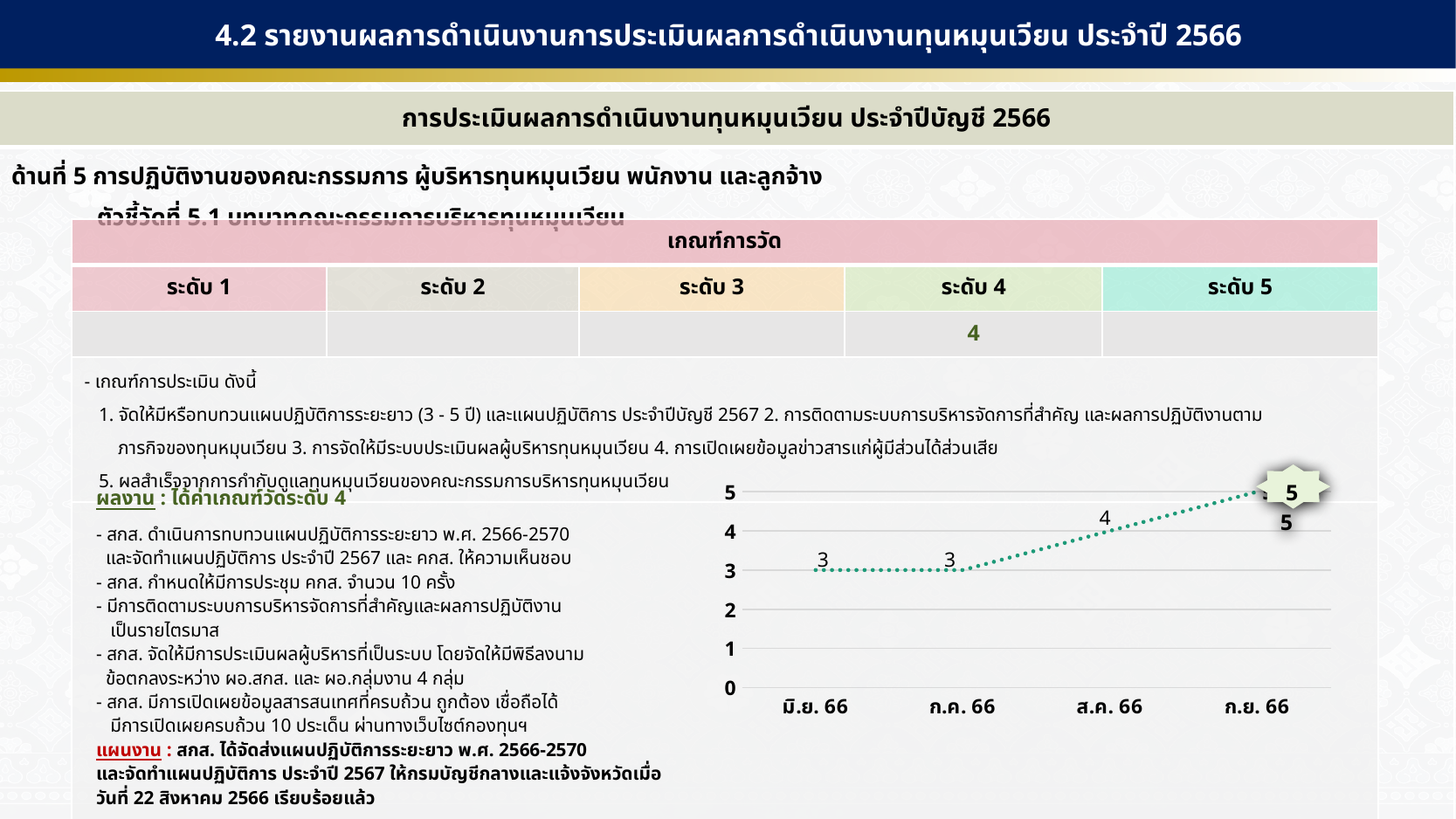
Which month has the highest value? ก.ย. 66 Which is larger, the value for ส.ค. 66 or the value for ก.ค. 66? ส.ค. 66 What is the value for ก.ค. 66? 3 What is the value for มิ.ย. 66? 3 Do the values rise or fall from มิ.ย. 66 to ก.ย. 66? rise What is the value for ส.ค. 66? 4 What is the value for ก.ย. 66? 5 What kind of chart is shown on the slide? line chart How many data points are plotted on the chart? 4 What is the highest tick value shown on the y axis? 5 What is the difference between the values for ก.ย. 66 and มิ.ย. 66? 2 What is the difference between the values for ส.ค. 66 and ก.ค. 66? 1